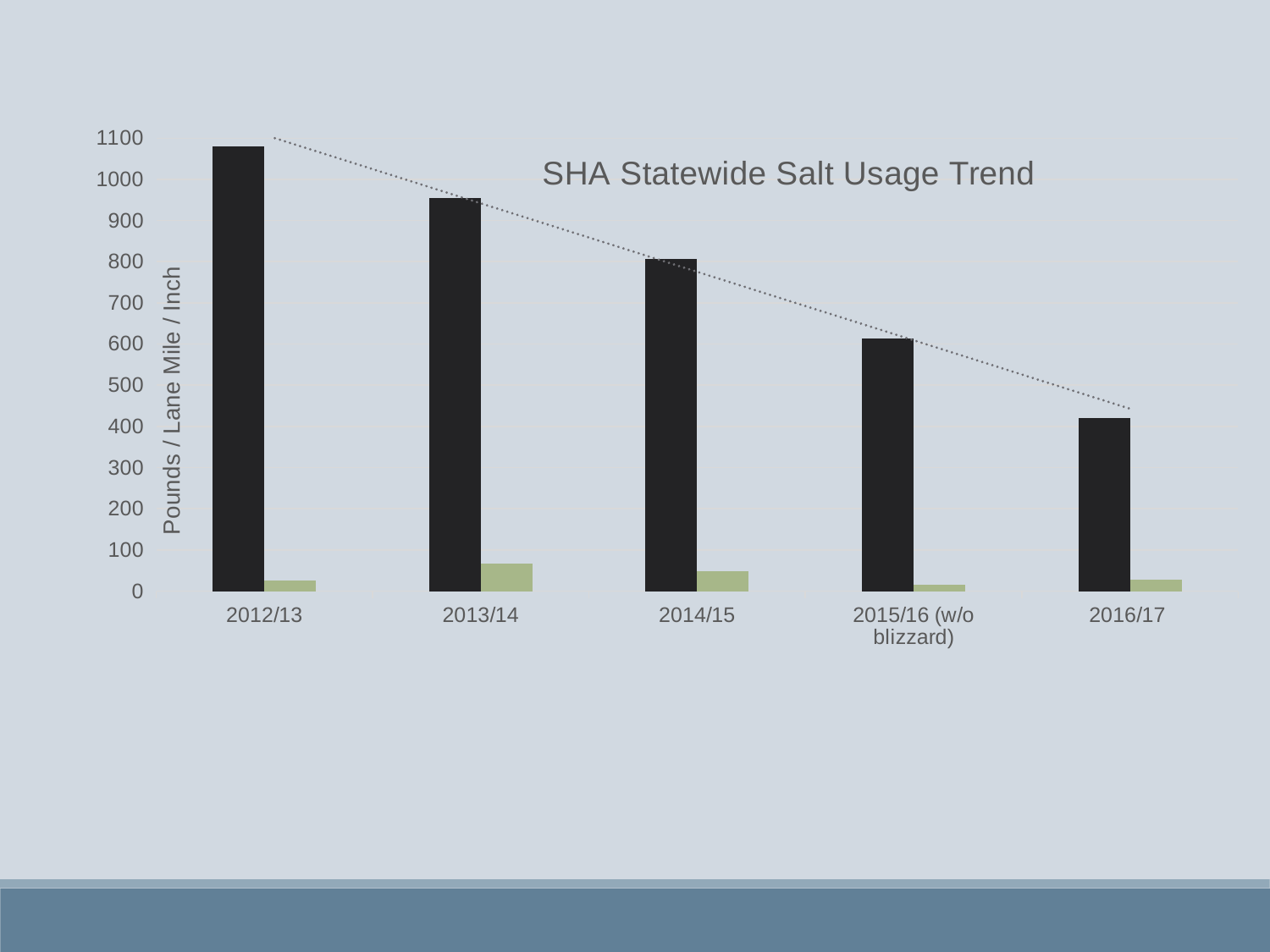
Which season has the tallest black bar? 2012/13 Do the black bars rise or fall from 2012/13 to 2016/17? Fall Is the black bar for 2016/17 greater or less than 500? less Is the black bar for 2012/13 greater or less than 1000? greater Is the black bar for 2013/14 greater or less than 1000? less What is the title of the chart? SHA Statewide Salt Usage Trend How many winter seasons (categories) are shown on the x axis? 5 What kind of chart is shown on the slide? Bar chart Which season has the tallest green bar? 2013/14 What is the label on the vertical axis of the chart? Pounds / Lane Mile / Inch Which season has the shortest black bar? 2016/17